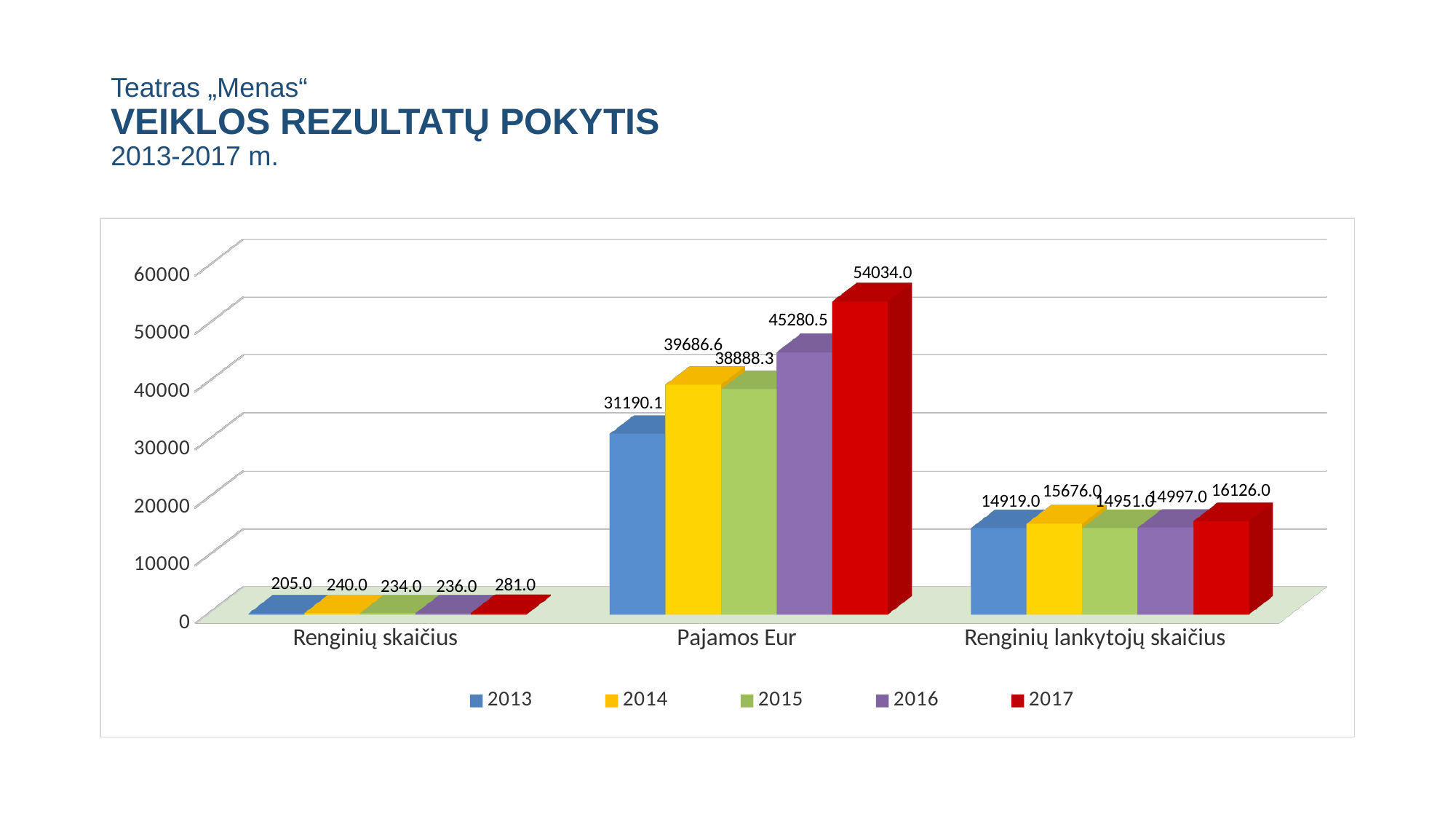
What is the value for 2014 in the Renginių lankytojų skaičius category? 15676.0 What kind of chart is shown on the slide? Bar chart How many series does the legend list? 5 Which year has the highest value in the Pajamos Eur category? 2017 Which year has the lowest value in the Renginių skaičius category? 2013 What is the value for 2017 in the Pajamos Eur category? 54034.0 What is the difference between the 2017 and 2013 values in the Pajamos Eur category? 22843.9 What is the difference between the 2017 and 2014 values in the Renginių skaičius category? 41.0 What is the value for 2013 in the Renginių skaičius category? 205.0 Which is larger in the Pajamos Eur category: the 2014 value or the 2015 value? 2014 Is the value for 2016 in the Pajamos Eur category greater or less than 40000? greater How many categories are shown on the x axis? 3